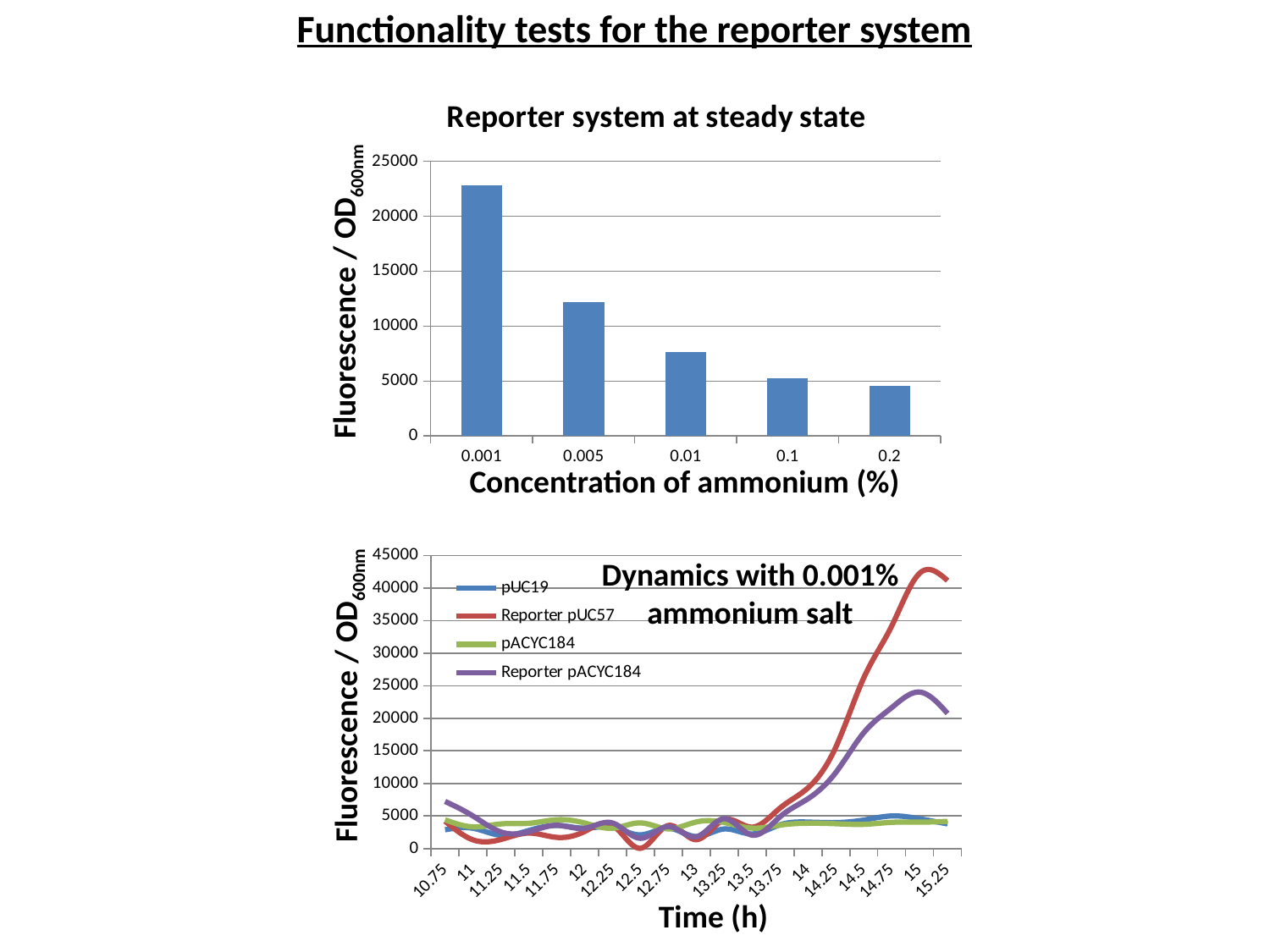
In the 'Dynamics with 0.001% ammonium salt' chart, how many series does the legend list? 4 In the 'Reporter system at steady state' chart, is the value for 0.01 greater or less than 10000? less In the 'Reporter system at steady state' chart, which has the larger value, 0.005 or 0.1? 0.005 In the 'Reporter system at steady state' chart, what kind of chart is it? bar chart In the 'Dynamics with 0.001% ammonium salt' chart, what kind of chart is it? line chart In the 'Reporter system at steady state' chart, is the value for 0.001 greater or less than 20000? greater In the 'Dynamics with 0.001% ammonium salt' chart, is the value for Reporter pUC57 at 15 greater or less than 40000? greater In the 'Reporter system at steady state' chart, which ammonium concentration has the lowest fluorescence / OD600nm? 0.2 In the 'Reporter system at steady state' chart, how many concentration categories are plotted? 5 In the 'Reporter system at steady state' chart, do the values rise or fall as the ammonium concentration increases along the x axis? fall In the 'Reporter system at steady state' chart, which ammonium concentration has the highest fluorescence / OD600nm? 0.001 In the 'Dynamics with 0.001% ammonium salt' chart, which series reaches the highest fluorescence / OD600nm? Reporter pUC57